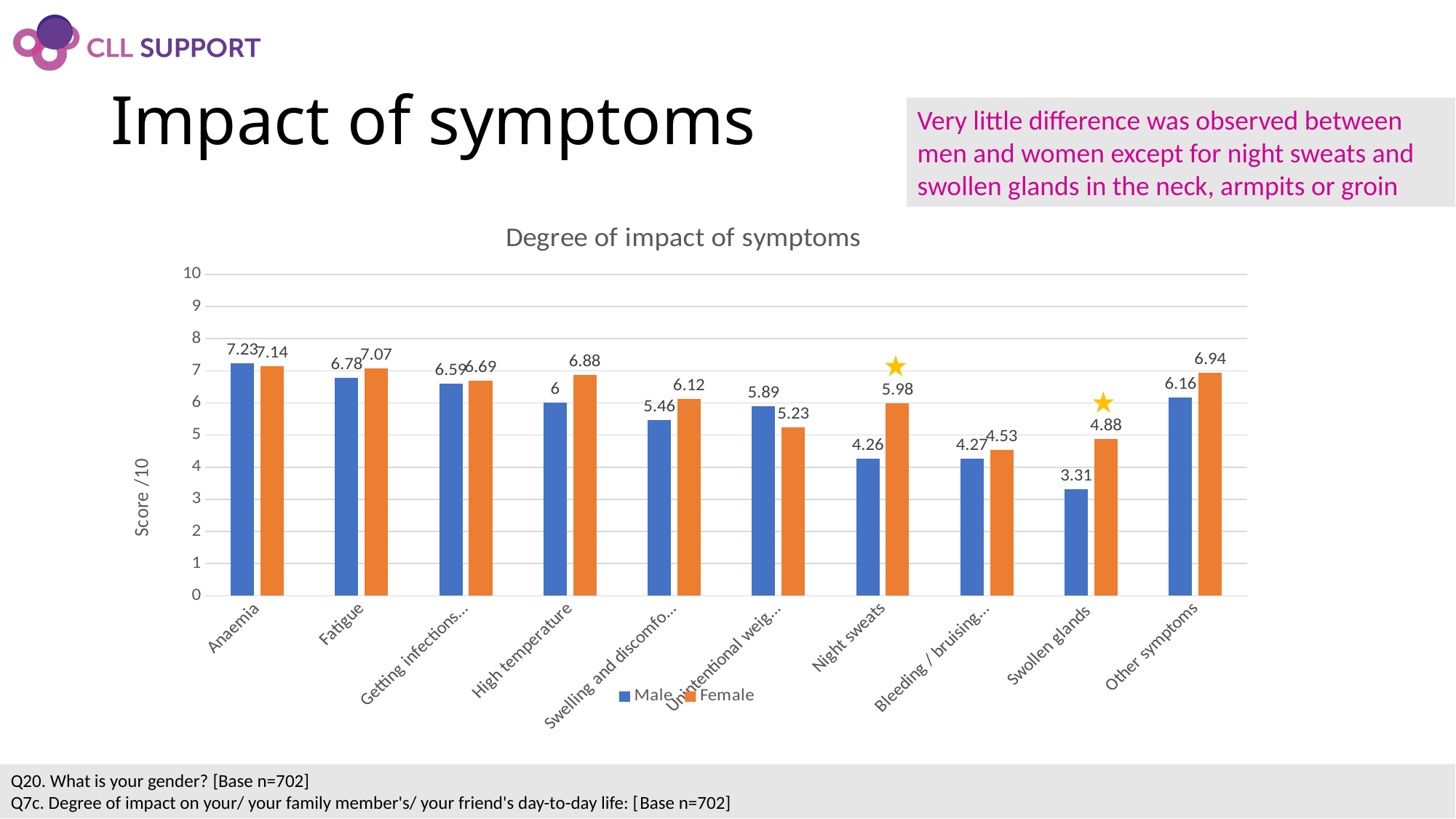
What is the difference between the Female and Male scores for Night sweats? 1.72 How many series does the legend list? 2 What is the Male score for Anaemia? 7.23 Which symptom has the highest Male score? Anaemia What is the Female score for Night sweats? 5.98 How many symptom categories are shown on the x axis? 10 What kind of chart is shown on the slide? Bar chart For High temperature, which is higher, the Male or the Female score? Female What is the Male score for Swollen glands? 3.31 What is the difference between the Female and Male scores for Swollen glands? 1.57 Which symptom has the lowest Male score? Swollen glands What is the title of the chart? Degree of impact of symptoms